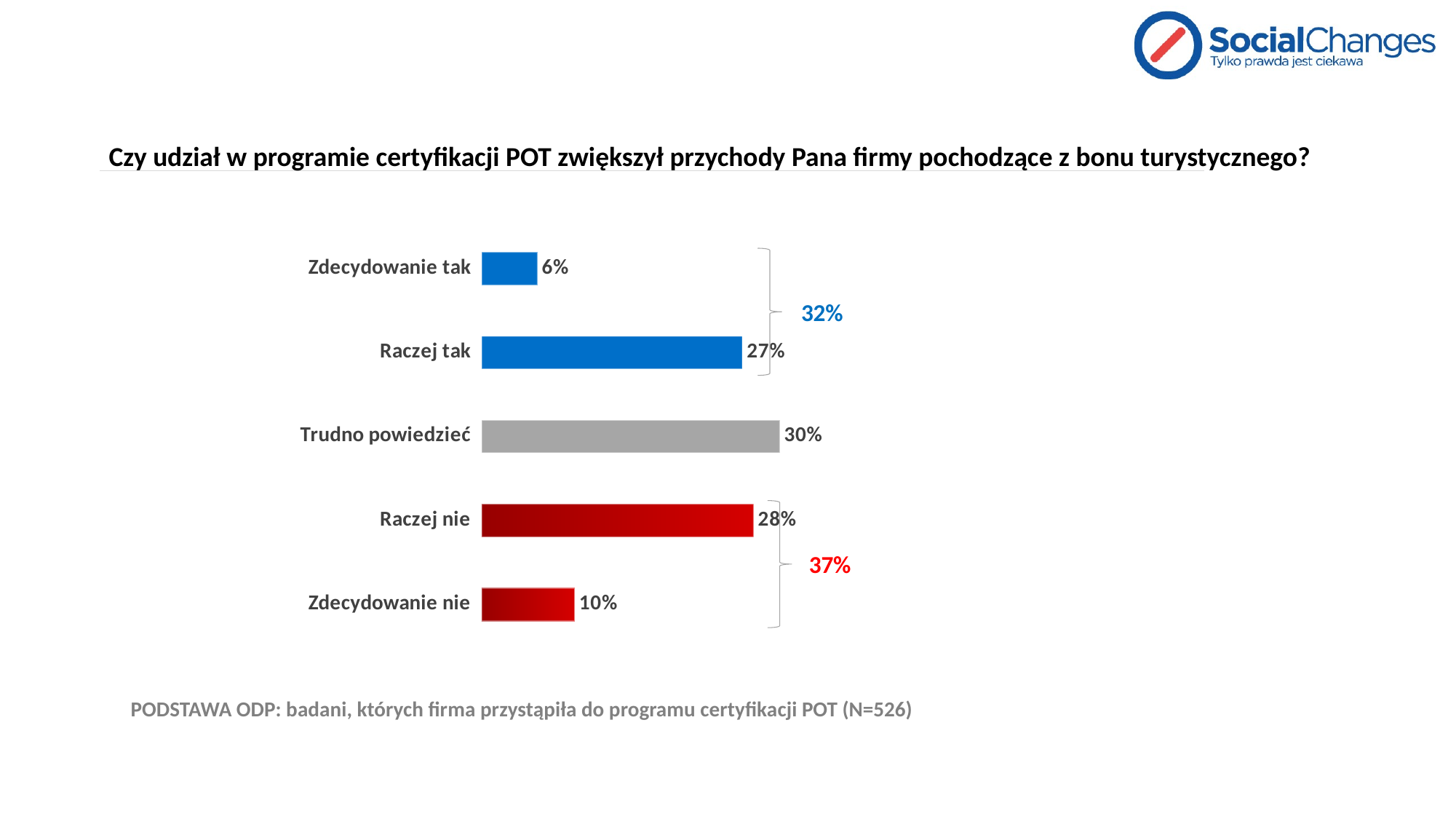
How many categories are shown in the chart? 5 Which is larger, the value for "Raczej tak" or the value for "Zdecydowanie nie"? Raczej tak Which category has the lowest value? Zdecydowanie tak What kind of chart is shown on the slide? Bar chart What is the value for "Raczej tak"? 27% What combined percentage is shown for the two "tak" answers (Zdecydowanie tak and Raczej tak)? 32% What is the difference between the values for "Raczej nie" and "Zdecydowanie nie"? 18% What is the value for "Zdecydowanie nie"? 10% What is the value for "Trudno powiedzieć"? 30% Which category has the highest value? Trudno powiedzieć What is the sample size (N) given in the note below the chart? N=526 What combined percentage is shown for the two "nie" answers (Raczej nie and Zdecydowanie nie)? 37%